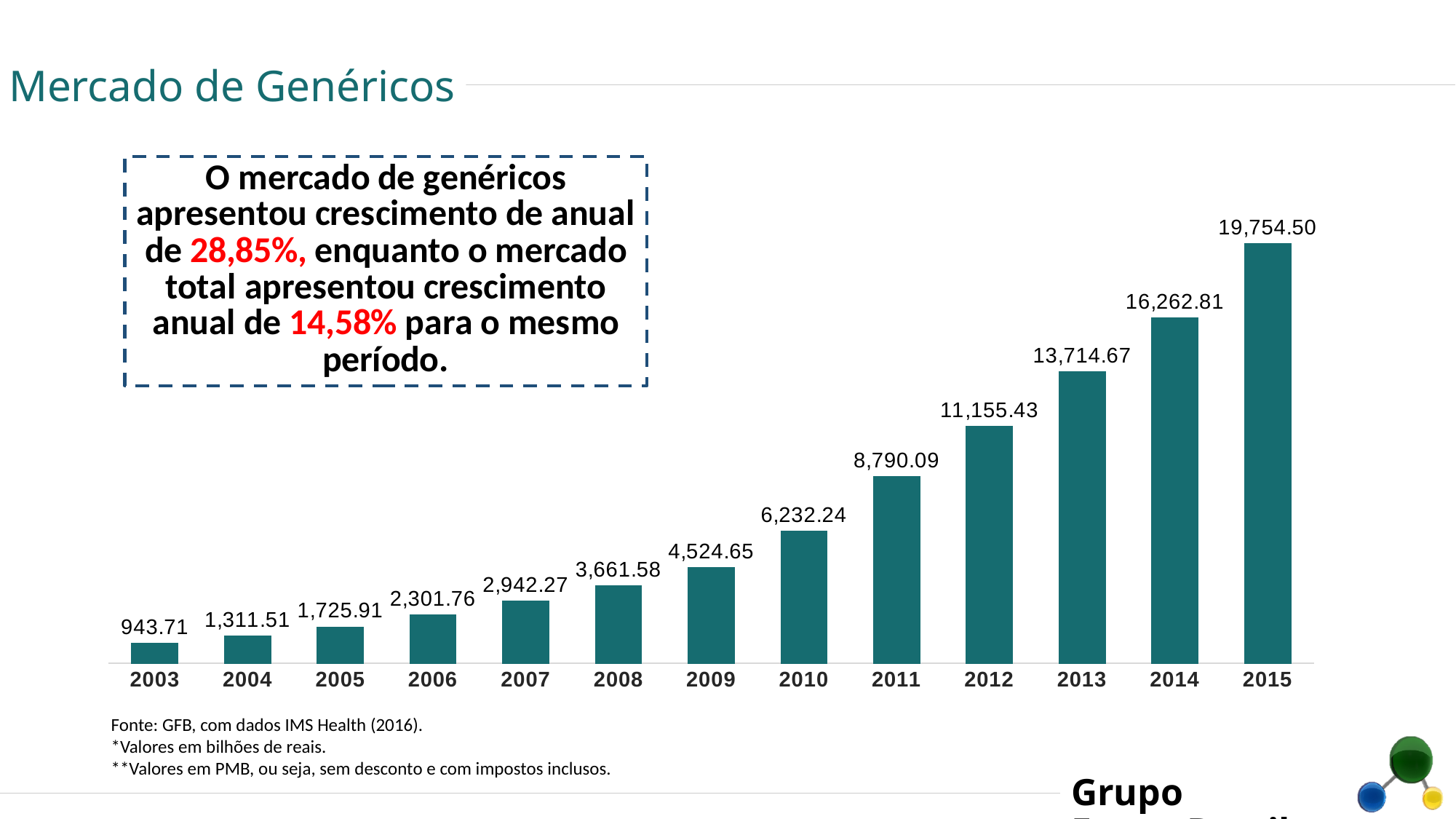
Which year has the lowest value? 2003 What is the value shown for 2010? 6,232.24 Do the values rise or fall from 2003 to 2015? Rise How many years are shown on the x axis? 13 What is the value shown for 2015? 19,754.50 Which year has the highest value? 2015 What is the value shown for 2013? 13,714.67 What is the difference between the values for 2004 and 2003? 367.80 What kind of chart is shown on the slide? Bar chart What is the difference between the values for 2015 and 2014? 3,491.69 What is the value shown for 2003? 943.71 Which is larger, the value for 2011 or the value for 2012? 2012